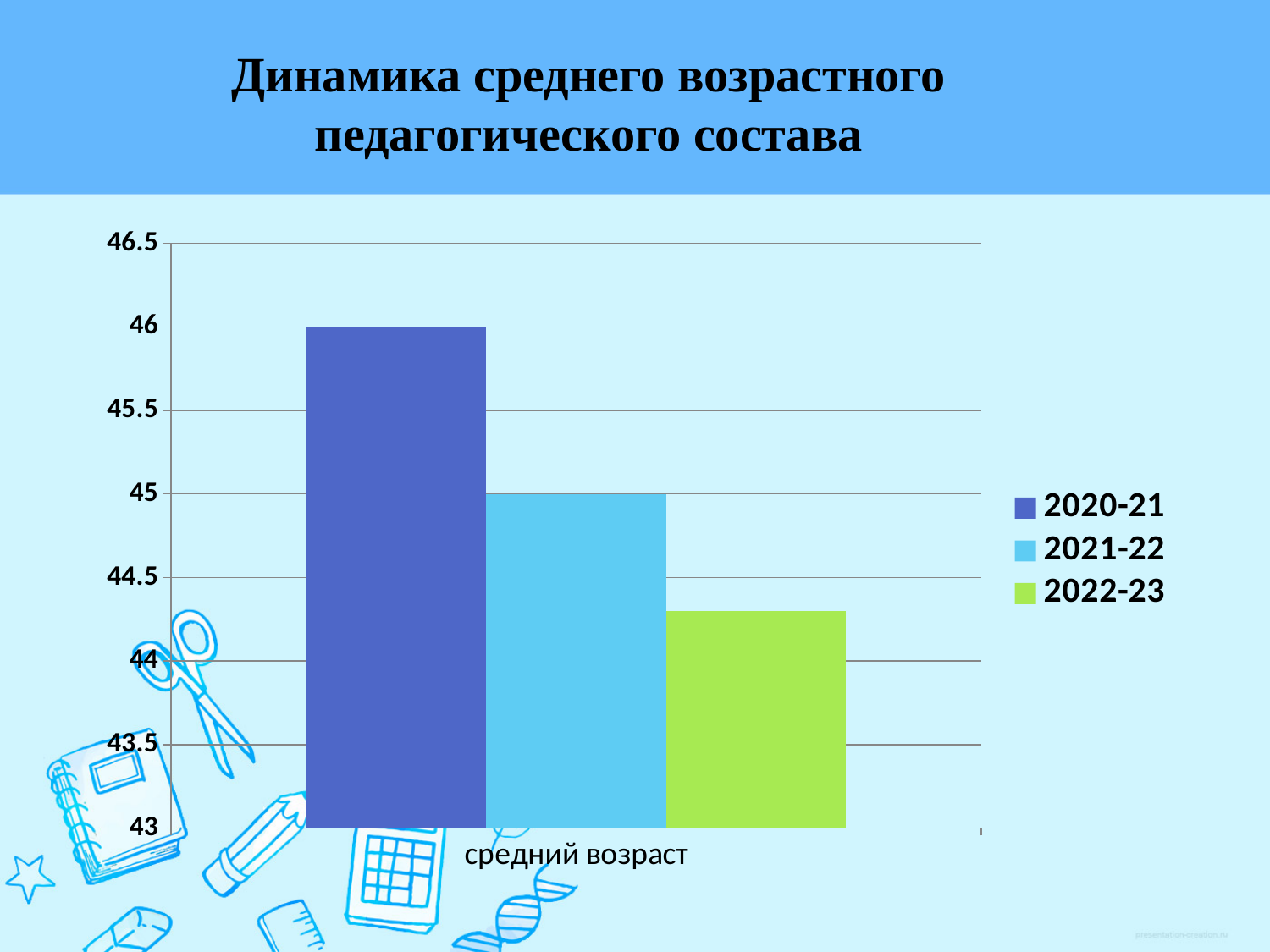
Is the value for 2022-23 greater or less than 44.5? less What is the value for 2020-21? 46 Which series has the highest value? 2020-21 How many categories are shown on the x axis? 1 Is the value for 2022-23 greater or less than 44? greater Do the values rise or fall from 2020-21 to 2022-23? fall How many series does the legend list? 3 Which is larger, the value for 2021-22 or the value for 2022-23? 2021-22 What type of chart is shown on the slide? bar chart What is the value for 2021-22? 45 What is the difference between the values for 2020-21 and 2021-22? 1 Which series has the lowest value? 2022-23